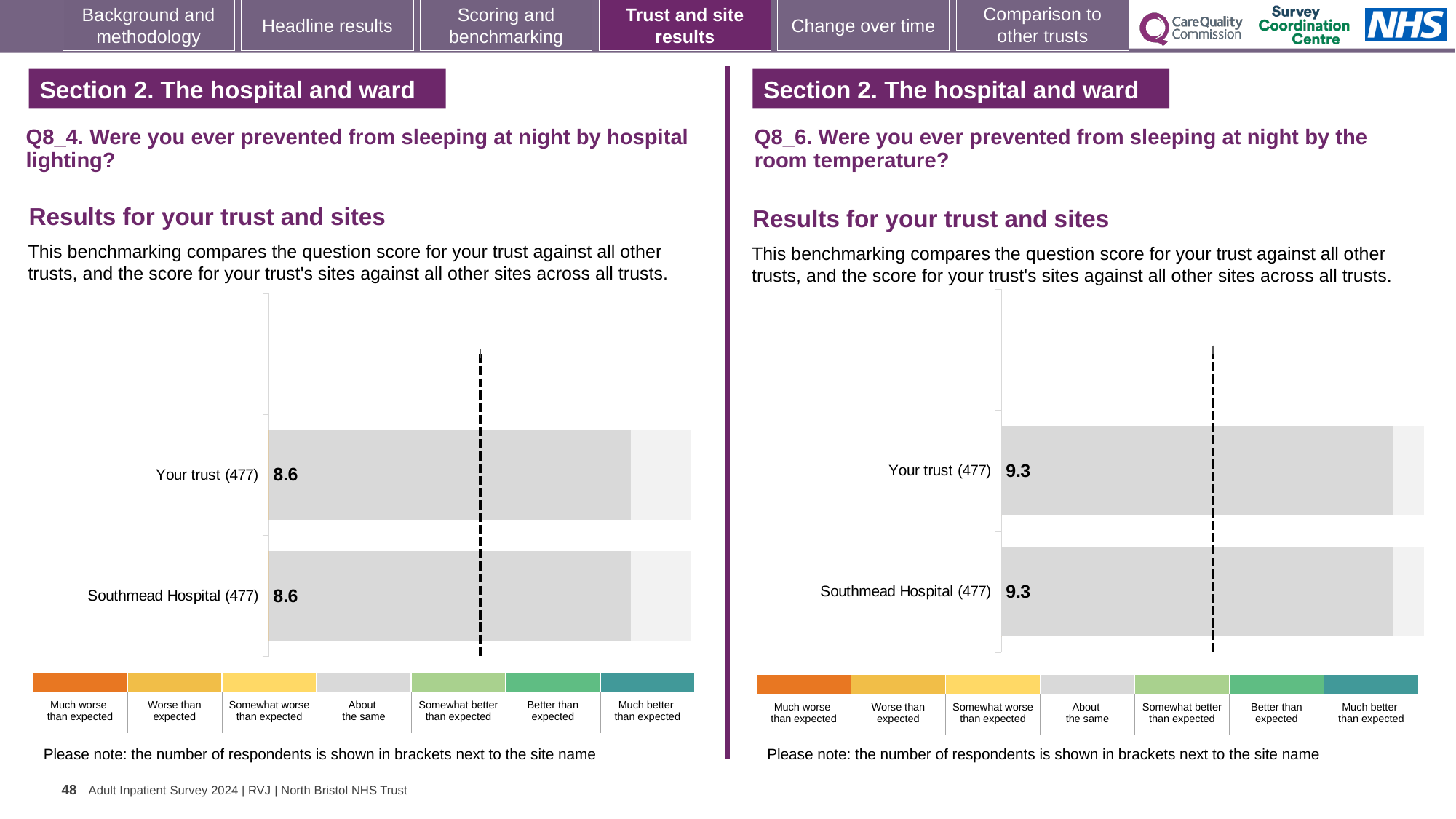
In the right chart (Q8_6, room temperature), what is the score for Southmead Hospital? 9.3 Is the score for Your trust in the right chart (Q8_6, room temperature) larger or smaller than the score for Your trust in the left chart (Q8_4, hospital lighting)? Larger In the right chart (Q8_6, room temperature), what is the score for Your trust? 9.3 In the left chart (Q8_4, hospital lighting), how many respondents are shown in brackets next to Southmead Hospital? 477 How many rating categories does the colour key below the right chart (Q8_6, room temperature) list? 7 In the left chart (Q8_4, hospital lighting), what is the score for Southmead Hospital? 8.6 In the left chart (Q8_4, hospital lighting), what is the difference between the score for Your trust and the score for Southmead Hospital? 0.0 What kind of chart is used in the left chart (Q8_4, hospital lighting)? Bar chart In the right chart (Q8_6, room temperature), what is the difference between the score for Your trust and the score for Southmead Hospital? 0.0 In the right chart (Q8_6, room temperature), how many bars are plotted? 2 In the left chart (Q8_4, hospital lighting), what is the score for Your trust? 8.6 In the left chart (Q8_4, hospital lighting), how many bars are plotted? 2